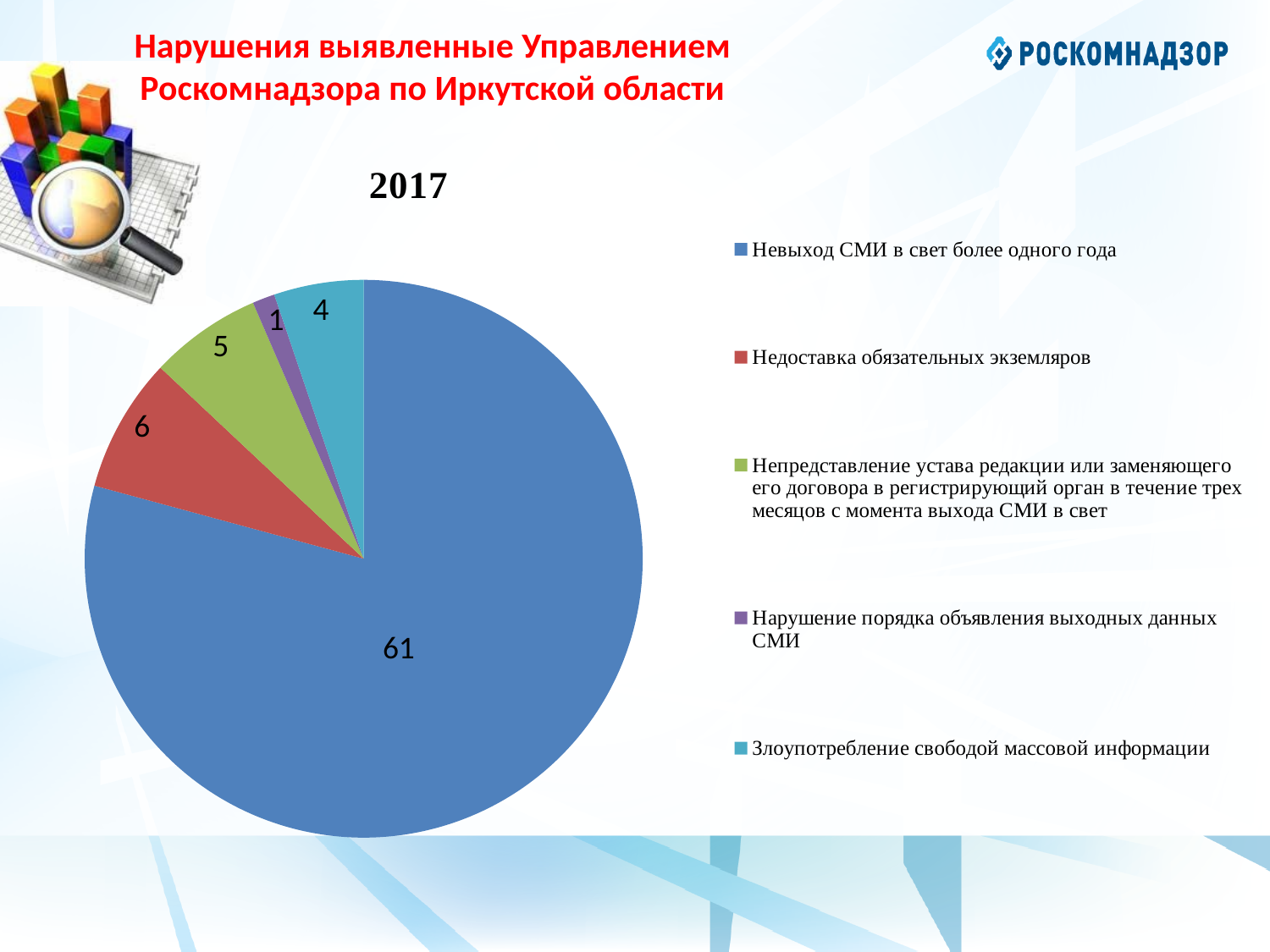
What is the difference between the value for "Невыход СМИ в свет более одного года" and the value for "Недоставка обязательных экземляров"? 55 What is the title of the chart? 2017 Which category has the smallest slice of the pie? Нарушение порядка объявления выходных данных СМИ What is the value for "Невыход СМИ в свет более одного года"? 61 What kind of chart is shown on the slide? Pie chart Which category has the largest slice of the pie? Невыход СМИ в свет более одного года Which is larger: the value for "Недоставка обязательных экземляров" or the value for "Злоупотребление свободой массовой информации"? Недоставка обязательных экземляров What is the value for "Нарушение порядка объявления выходных данных СМИ"? 1 What is the value for "Злоупотребление свободой массовой информации"? 4 How many categories does the legend list? 5 What is the total of all slices in the pie chart? 77 What is the value for "Недоставка обязательных экземляров"? 6